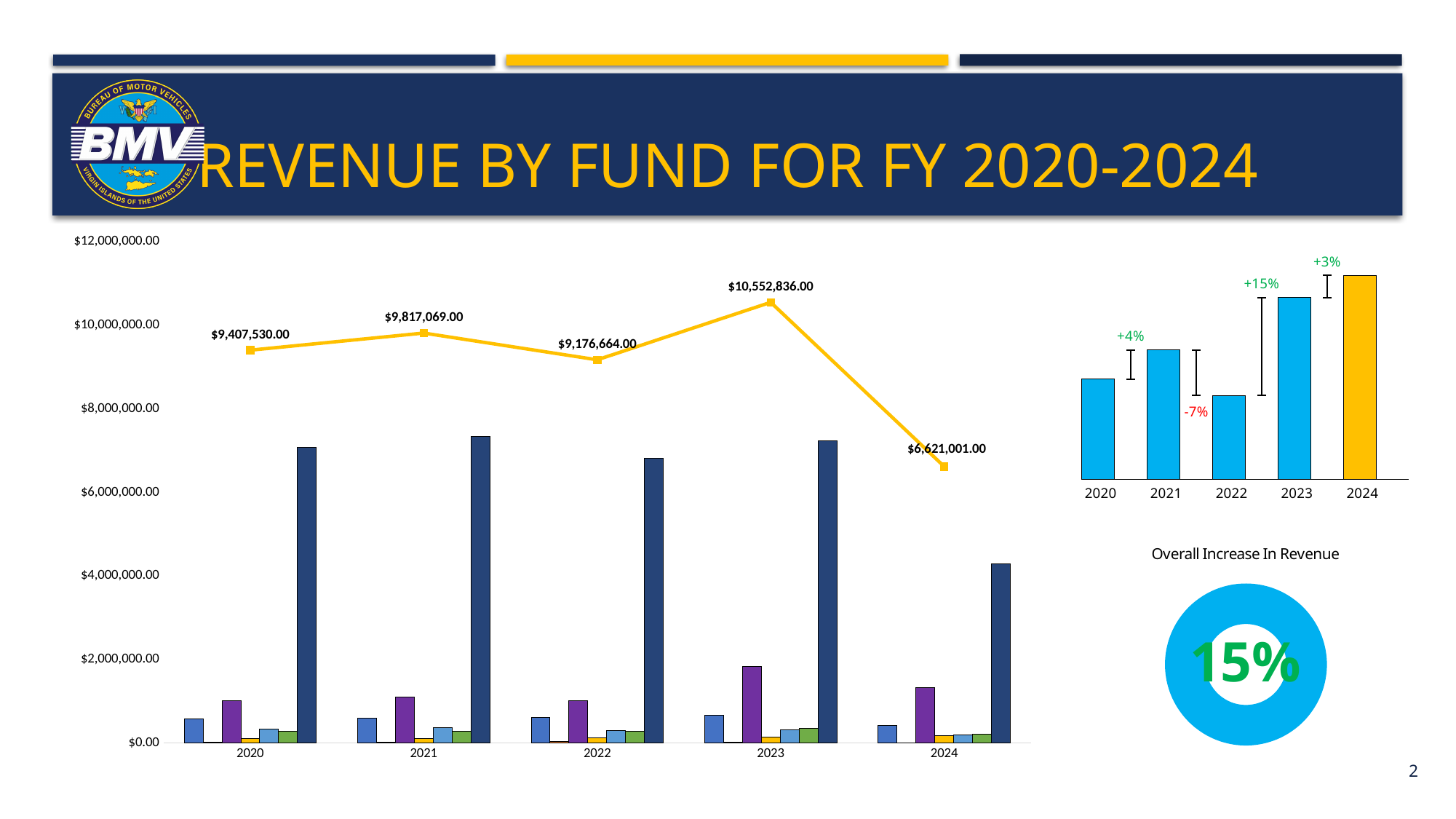
On the main chart, is the tallest bar in 2021 greater or less than $6,000,000.00? greater On the main chart, which is larger, the line value for 2021 or for 2022? 2021 On the main chart, what is the labelled value of the line for 2020? $9,407,530.00 On the small chart at the top right, what percentage change is labelled between 2022 and 2023? +15% On the main chart, what is the difference between the line values for 2023 and 2022? $1,376,172.00 On the main chart, what is the labelled value of the line for 2024? $6,621,001.00 On the main chart, is the tallest bar in 2024 greater or less than $6,000,000.00? less On the main chart, in which year does the line reach its highest labelled value? 2023 On the small chart at the top right, which year has the tallest bar? 2024 On the main chart, what is the labelled value of the line for 2023? $10,552,836.00 How many years are shown on the x axis of the main chart? 5 On the main chart, in which year does the line have its lowest labelled value? 2024